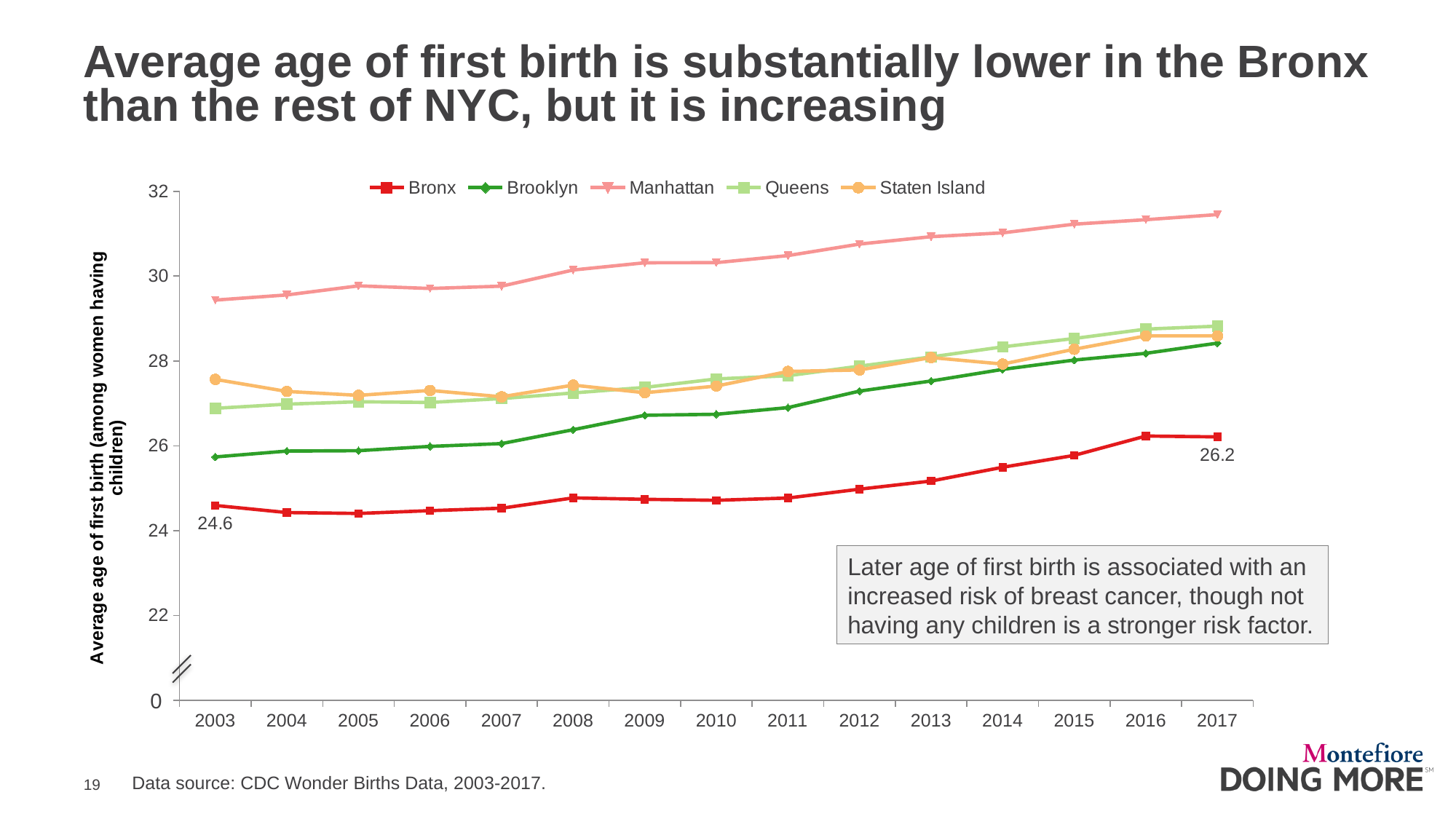
How many series does the legend list? 5 What kind of chart is shown on the slide? line chart Is the value for Manhattan in 2017 greater or less than 30? greater What is the average age of first birth in the Bronx in 2003? 24.6 Is the value for Brooklyn in 2003 greater or less than 26? less Which borough has the lowest average age of first birth across the years shown? Bronx By how much did the Bronx average age of first birth increase from 2003 to 2017? 1.6 How many years are shown on the x axis? 15 Which borough has the highest average age of first birth in 2017? Manhattan In 2010, which has a higher average age of first birth, Manhattan or Brooklyn? Manhattan Does the Bronx average age of first birth rise or fall from 2003 to 2017? rise What is the average age of first birth in the Bronx in 2017? 26.2